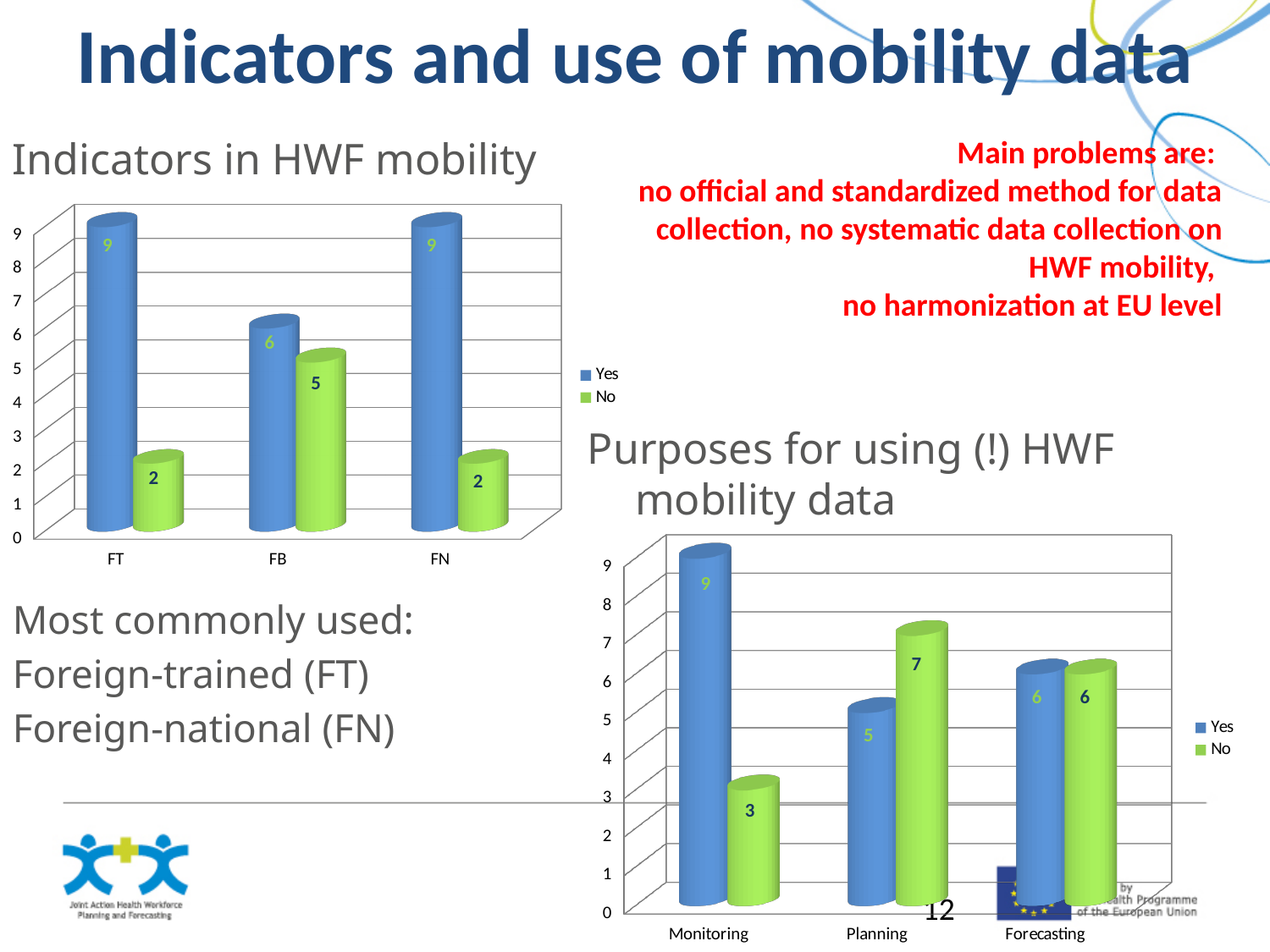
In the 'Indicators in HWF mobility' chart, what is the difference between the Yes and No values for FN? 7 In the 'Indicators in HWF mobility' chart, what is the No value for FB? 5 In the 'Purposes for using (!) HWF mobility data' chart, what is the difference between the Yes and No values for Monitoring? 6 In the 'Purposes for using (!) HWF mobility data' chart, which is larger for Planning, the Yes value or the No value? No In the 'Indicators in HWF mobility' chart, which category has the lowest Yes value? FB What kind of chart is the 'Purposes for using (!) HWF mobility data' chart? Bar chart In the 'Indicators in HWF mobility' chart, how many categories are shown on the x axis? 3 In the 'Purposes for using (!) HWF mobility data' chart, what is the No value for Planning? 7 In the 'Purposes for using (!) HWF mobility data' chart, which category has the highest Yes value? Monitoring In the 'Indicators in HWF mobility' chart, what is the Yes value for FT? 9 In the 'Indicators in HWF mobility' chart, how many series does the legend list? 2 In the 'Purposes for using (!) HWF mobility data' chart, what is the Yes value for Forecasting? 6